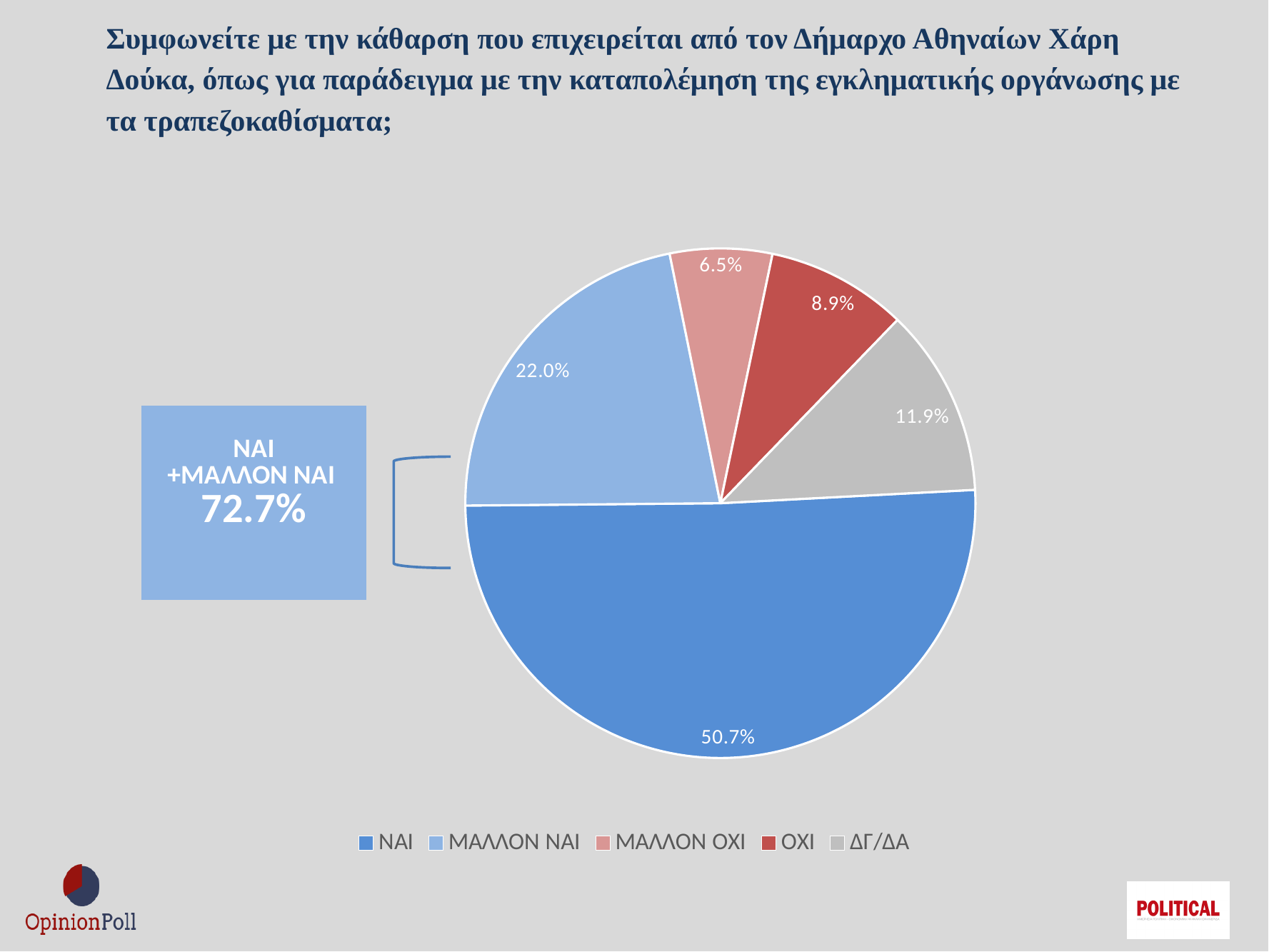
What is the difference in percentage points between the ΝΑΙ slice and the ΜΑΛΛΟΝ ΝΑΙ slice? 28.7 What combined percentage is shown in the box for ΝΑΙ + ΜΑΛΛΟΝ ΝΑΙ? 72.7% What type of chart is shown on the slide? Pie chart What percentage of the pie chart is labelled ΝΑΙ? 50.7% What percentage of the pie chart is labelled ΜΑΛΛΟΝ ΝΑΙ? 22.0% How many slices does the pie chart have? 5 Which category has the smallest slice of the pie chart? ΜΑΛΛΟΝ ΟΧΙ What percentage of the pie chart is labelled ΟΧΙ? 8.9% What percentage of the pie chart is labelled ΔΓ/ΔΑ? 11.9% Which category has the largest slice of the pie chart? ΝΑΙ What percentage of the pie chart is labelled ΜΑΛΛΟΝ ΟΧΙ? 6.5% Which slice is larger, ΟΧΙ or ΔΓ/ΔΑ? ΔΓ/ΔΑ